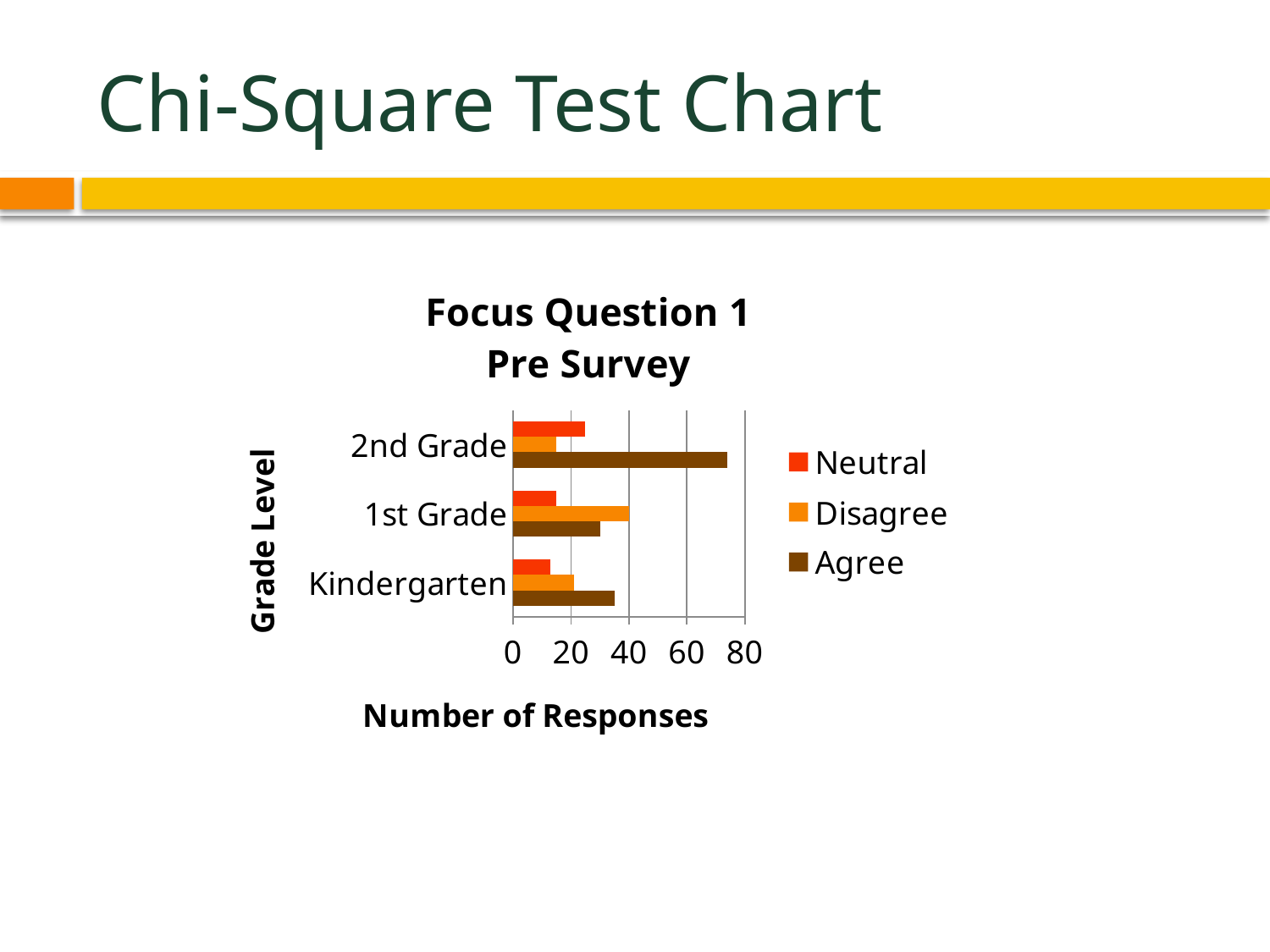
Is the Neutral value for Kindergarten greater or less than 20? less How many grade levels are shown on the chart? 3 What is the title of the chart? Focus Question 1 Pre Survey Is the Agree value for 2nd Grade greater or less than 60? greater For 1st Grade, which is larger, the Disagree value or the Agree value? Disagree Which grade level has the highest Neutral value? 2nd Grade Which grade level has the highest Agree value? 2nd Grade What kind of chart is shown on the slide? Bar chart How many series does the legend list? 3 What is the label of the horizontal axis? Number of Responses Which grade level has the highest Disagree value? 1st Grade For Kindergarten, which is larger, the Agree value or the Neutral value? Agree